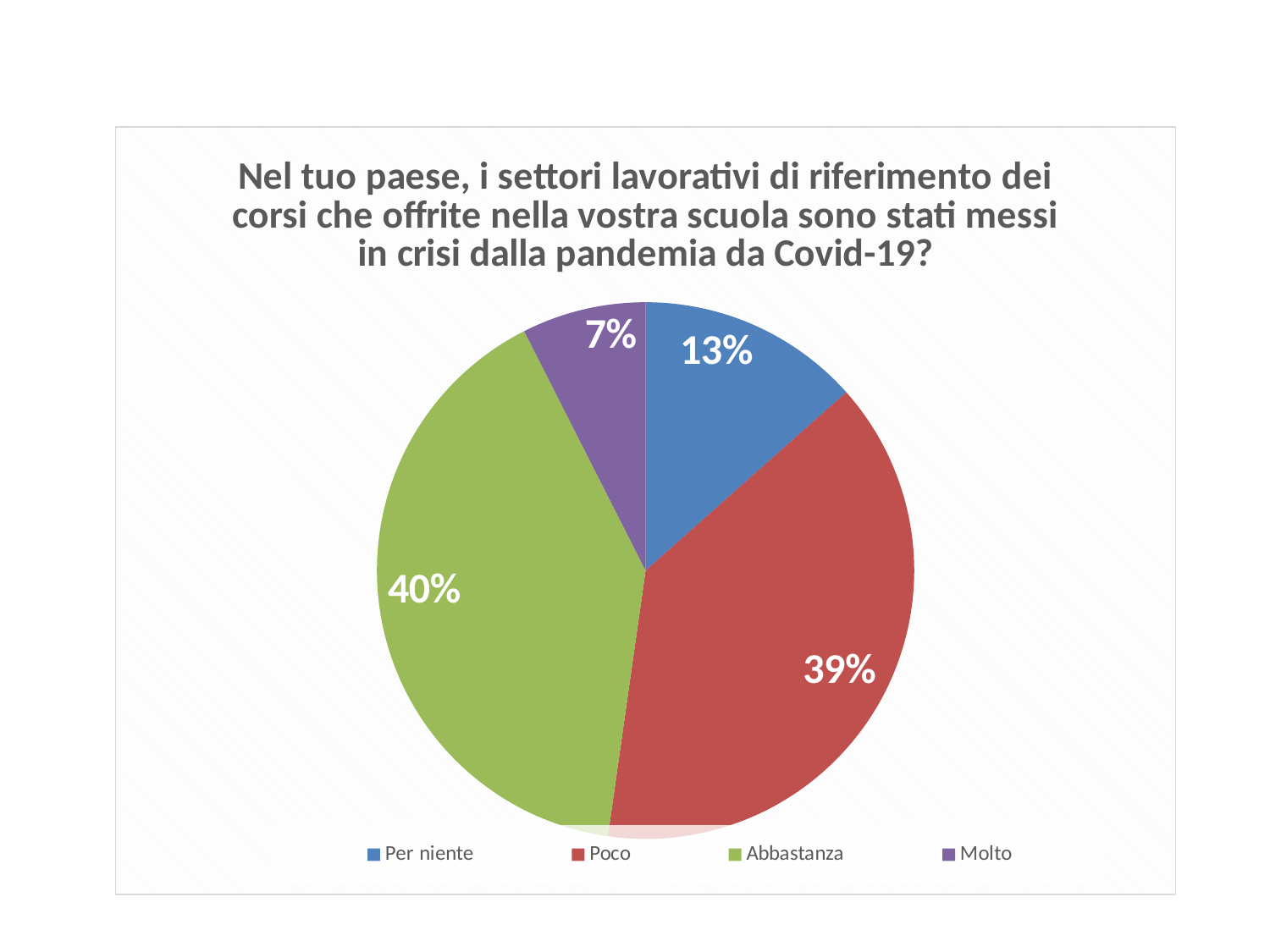
What colour is the 'Abbastanza' slice? green What kind of chart is shown on the slide? pie chart Which category is shown in purple in the legend? Molto What percentage of the pie is the 'Abbastanza' slice? 40% What percentage of the pie is the 'Molto' slice? 7% Which category has the largest slice of the pie? Abbastanza Which category has the smallest slice of the pie? Molto What percentage of the pie is the 'Per niente' slice? 13% What percentage of the pie is the 'Poco' slice? 39% What is the difference in percentage points between the 'Poco' slice and the 'Per niente' slice? 26 How many categories does the pie chart show? 4 Which slice is larger, 'Per niente' or 'Poco'? Poco